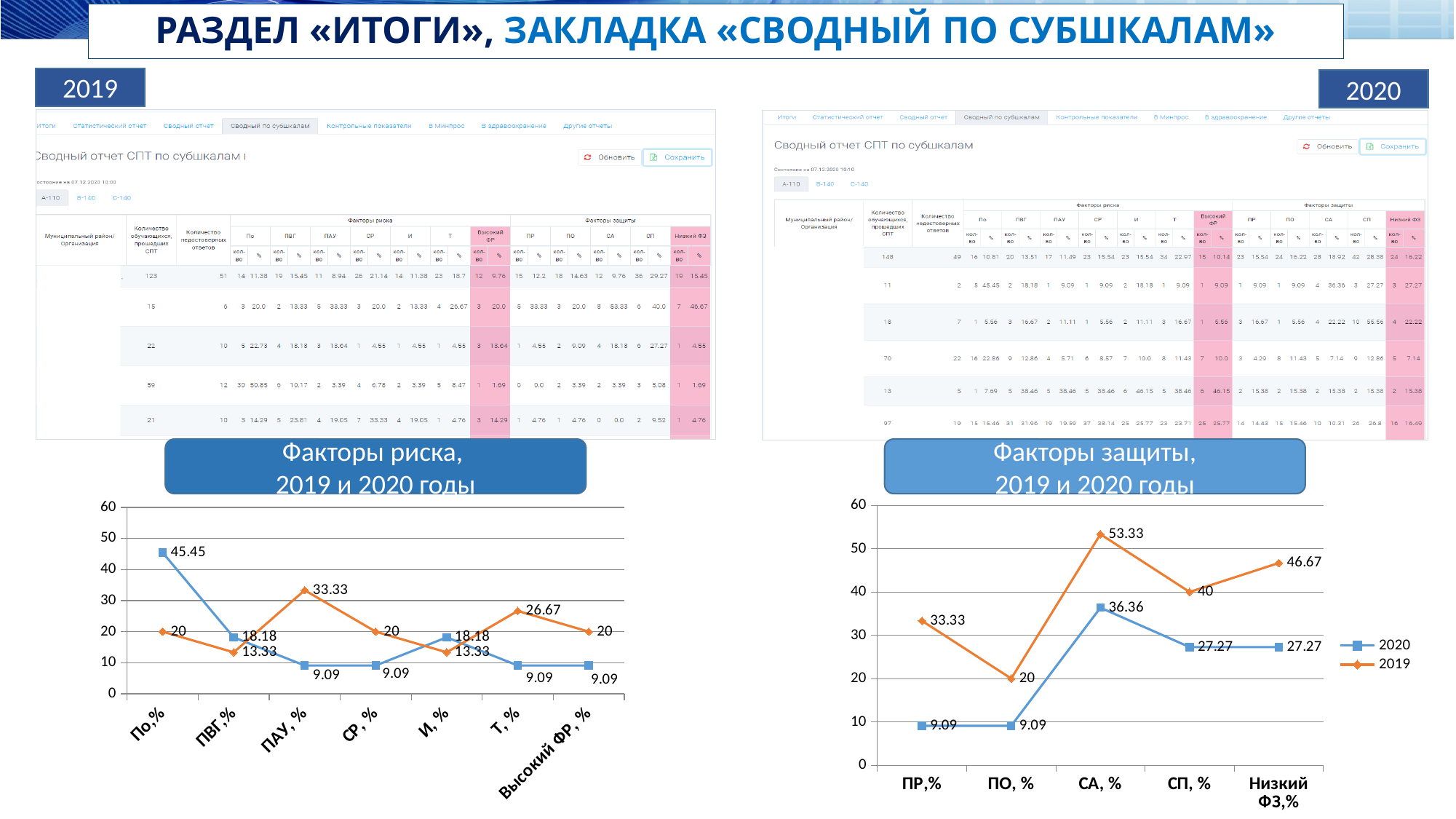
How many series does the legend of the chart titled «Факторы защиты, 2019 и 2020 годы» list? 2 In the chart titled «Факторы защиты, 2019 и 2020 годы», what is the difference between the 2019 and 2020 values at СА, %? 16.97 In the chart titled «Факторы защиты, 2019 и 2020 годы», which series has the larger value at ПР,%: 2019 or 2020? 2019 In the chart titled «Факторы риска, 2019 и 2020 годы», what is the value of the orange line at ПАУ, %? 33.33 How many categories are shown on the x axis of the chart titled «Факторы защиты, 2019 и 2020 годы»? 5 In the chart titled «Факторы защиты, 2019 и 2020 годы», which category has the lowest value for the 2019 series? ПО, % How many categories are shown on the x axis of the chart titled «Факторы риска, 2019 и 2020 годы»? 7 In the chart titled «Факторы защиты, 2019 и 2020 годы», which category has the highest value for the 2019 series? СА, % In the chart titled «Факторы защиты, 2019 и 2020 годы», what is the value for the 2020 series at СП, %? 27.27 In the chart titled «Факторы риска, 2019 и 2020 годы», at which category does the blue line reach its highest value? По,% In the chart titled «Факторы защиты, 2019 и 2020 годы», what is the value for the 2019 series at СА, %? 53.33 What kind of chart is the one titled «Факторы риска, 2019 и 2020 годы»? line chart